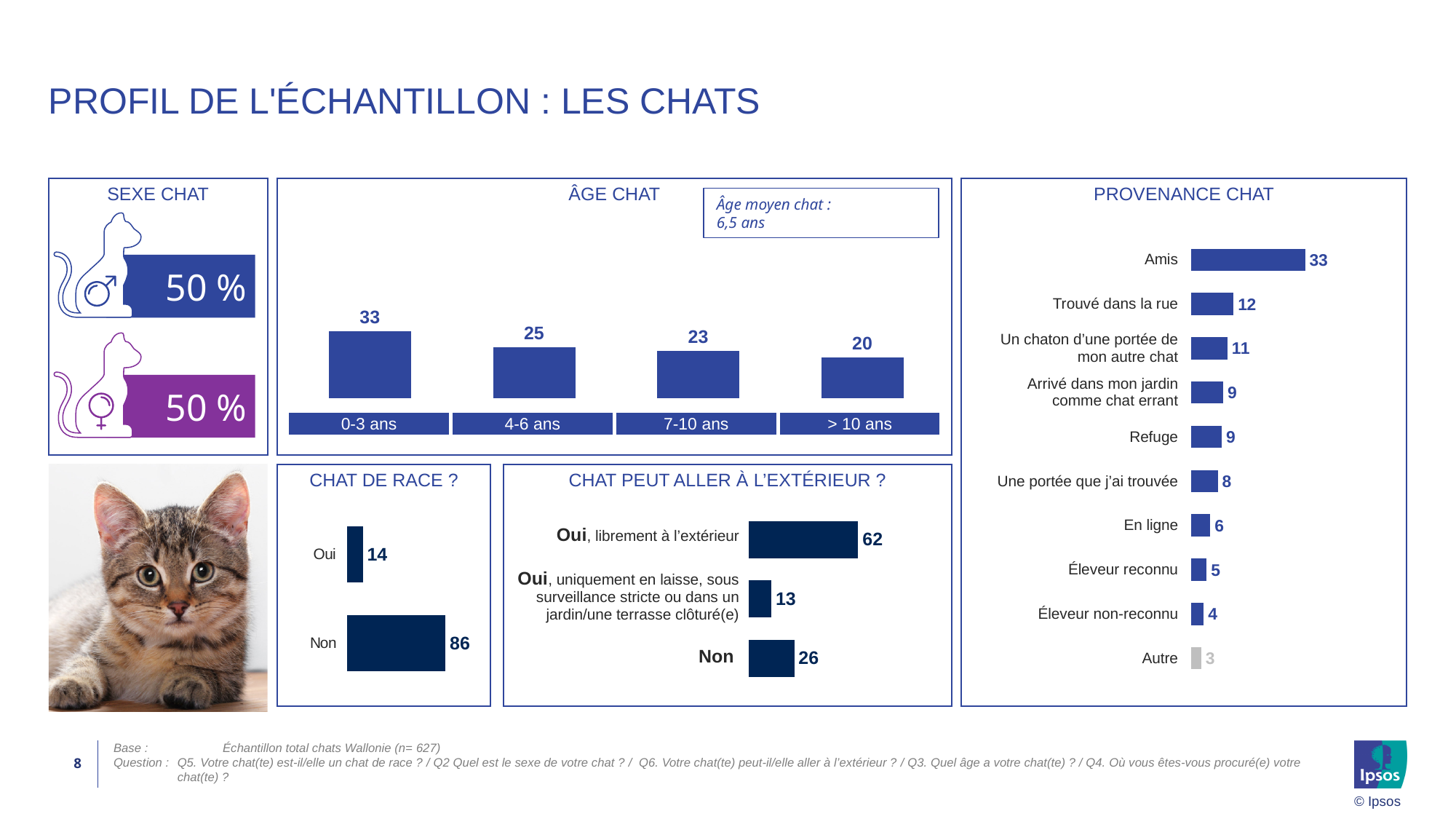
In the CHAT PEUT ALLER À L'EXTÉRIEUR ? chart, what is the value for Oui, librement à l'extérieur? 62 In the ÂGE CHAT chart, which age category has the lowest value? > 10 ans In the CHAT DE RACE ? chart, what is the value for Non? 86 In the PROVENANCE CHAT chart, what is the difference between Amis and En ligne? 27 In the ÂGE CHAT chart, what is the value for 0-3 ans? 33 In the ÂGE CHAT chart, do the values rise or fall from 0-3 ans to > 10 ans? fall In the PROVENANCE CHAT chart, how many categories are shown? 10 What kind of chart is the PROVENANCE CHAT chart? bar chart In the CHAT PEUT ALLER À L'EXTÉRIEUR ? chart, which is larger: Non or Oui, uniquement en laisse? Non In the ÂGE CHAT chart, how many age categories are shown? 4 In the PROVENANCE CHAT chart, what is the value for Trouvé dans la rue? 12 In the PROVENANCE CHAT chart, which category has the highest value? Amis